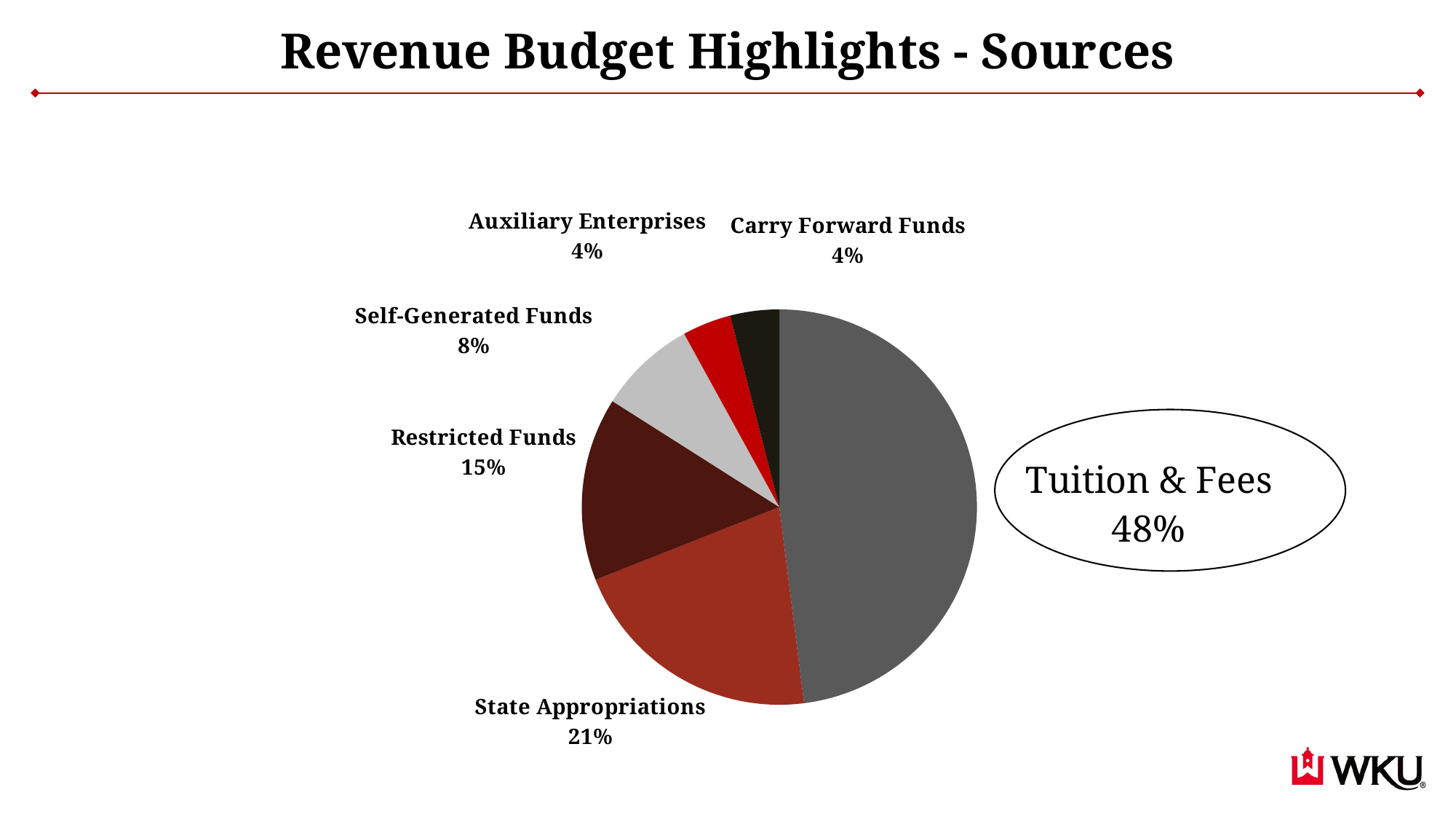
What is the value for State Appropriations? 21% What is the value for Restricted Funds? 15% How many categories are shown in the pie chart? 6 What share of the pie is Tuition & Fees? 48% Which category has the largest share of the pie? Tuition & Fees What is the title of the slide containing the chart? Revenue Budget Highlights - Sources What is the value for Carry Forward Funds? 4% What is the value for Self-Generated Funds? 8% Which is larger, Restricted Funds or Self-Generated Funds? Restricted Funds What is the difference between State Appropriations and Restricted Funds? 6% What kind of chart is shown on the slide? Pie chart What is the difference between Tuition & Fees and State Appropriations? 27%